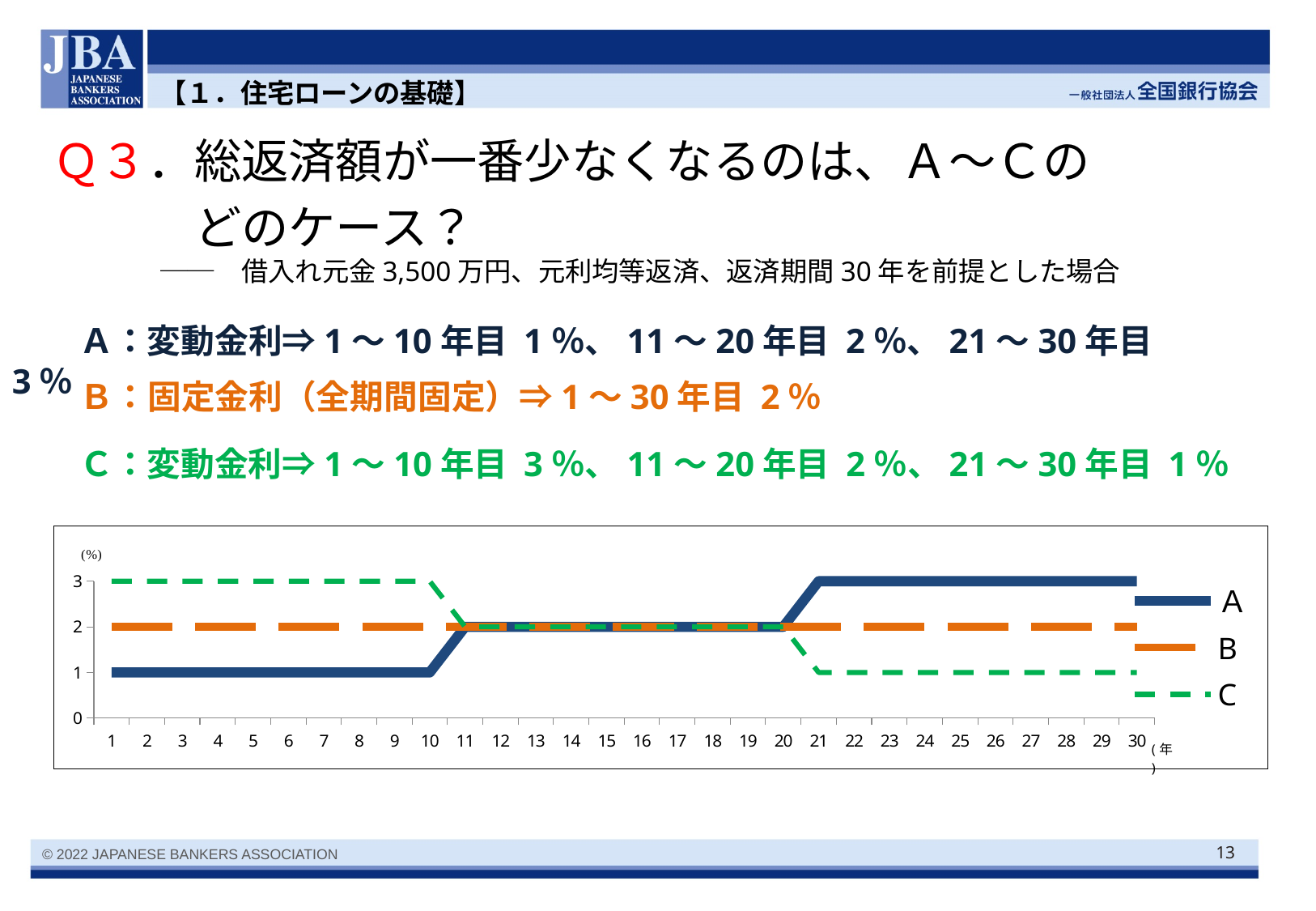
What is the interest rate for series A in year 25? 3 What is the interest rate for series C in year 28? 1 What is the unit shown on the y axis of the chart? % What kind of chart is shown on the slide? line chart What is the interest rate for series B in year 15? 2 What is the difference between the values of series C and series A in year 5? 2 Does series A rise or fall over the 30 years shown on the x axis? rise What is the interest rate for series A in year 5? 1 How many series does the chart legend list? 3 Which series has the lowest value in year 30? C What is the interest rate for series C in year 3? 3 Which series has the highest value in year 1? C